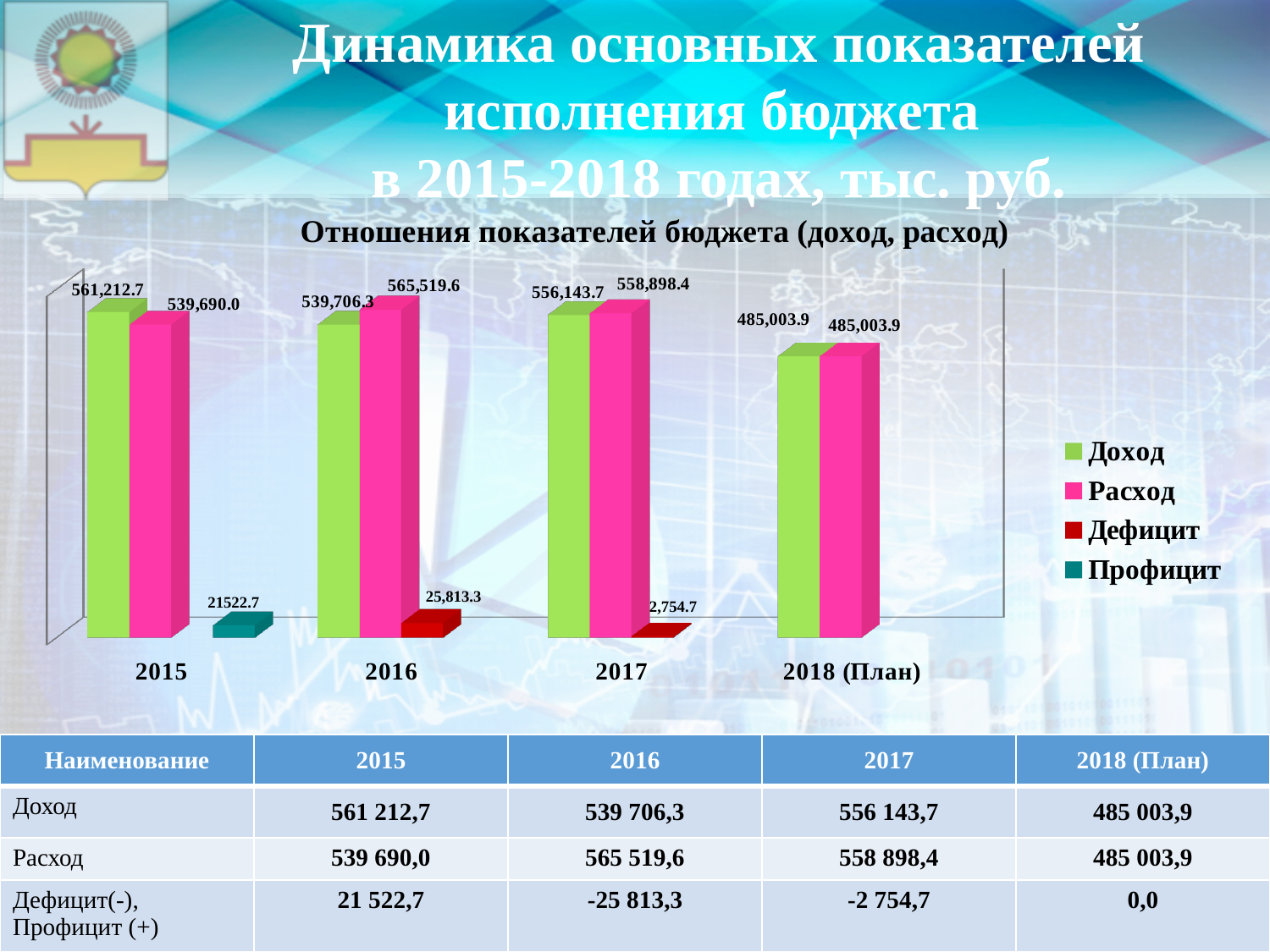
In which year is Расход lowest in the chart? 2018 (План) How many year categories are shown on the x axis of the chart? 4 How many series does the chart legend list? 4 What is the Дефицит value shown for 2017 in the chart? 2,754.7 Which series in the chart legend is shown in pink? Расход What is the value of Расход for 2016 in the chart? 565,519.6 What is the value of Расход for 2018 (План) in the chart? 485,003.9 In which year is Доход highest in the chart? 2015 What is the difference between Расход and Доход for 2016 in the chart? 25,813.3 What type of chart is shown on the slide? Bar chart What is the value of Доход for 2015 in the chart? 561,212.7 For 2015, which is larger in the chart: Доход or Расход? Доход